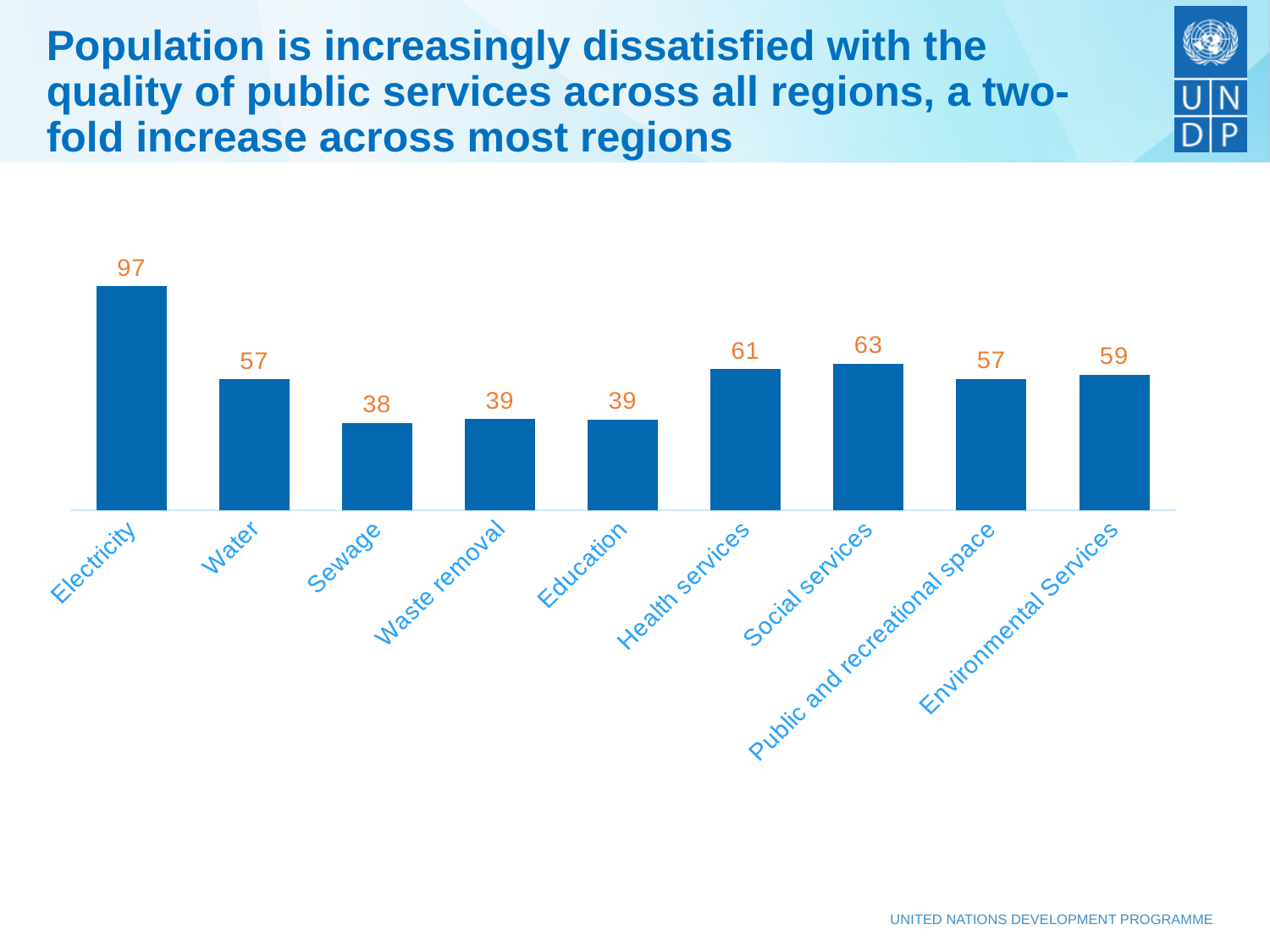
Which category has the highest value? Electricity What is the value for Public and recreational space? 57 What is the value for Social services? 63 What is the value for Waste removal? 39 What is the value for Electricity? 97 How many categories are shown in the chart? 9 What is the difference between the values for Electricity and Water? 40 What kind of chart is shown on the slide? Bar chart Which category has the lowest value? Sewage What colour are the bars in the chart? Blue Which is larger, the value for Health services or the value for Environmental Services? Health services What is the difference between the values for Social services and Health services? 2